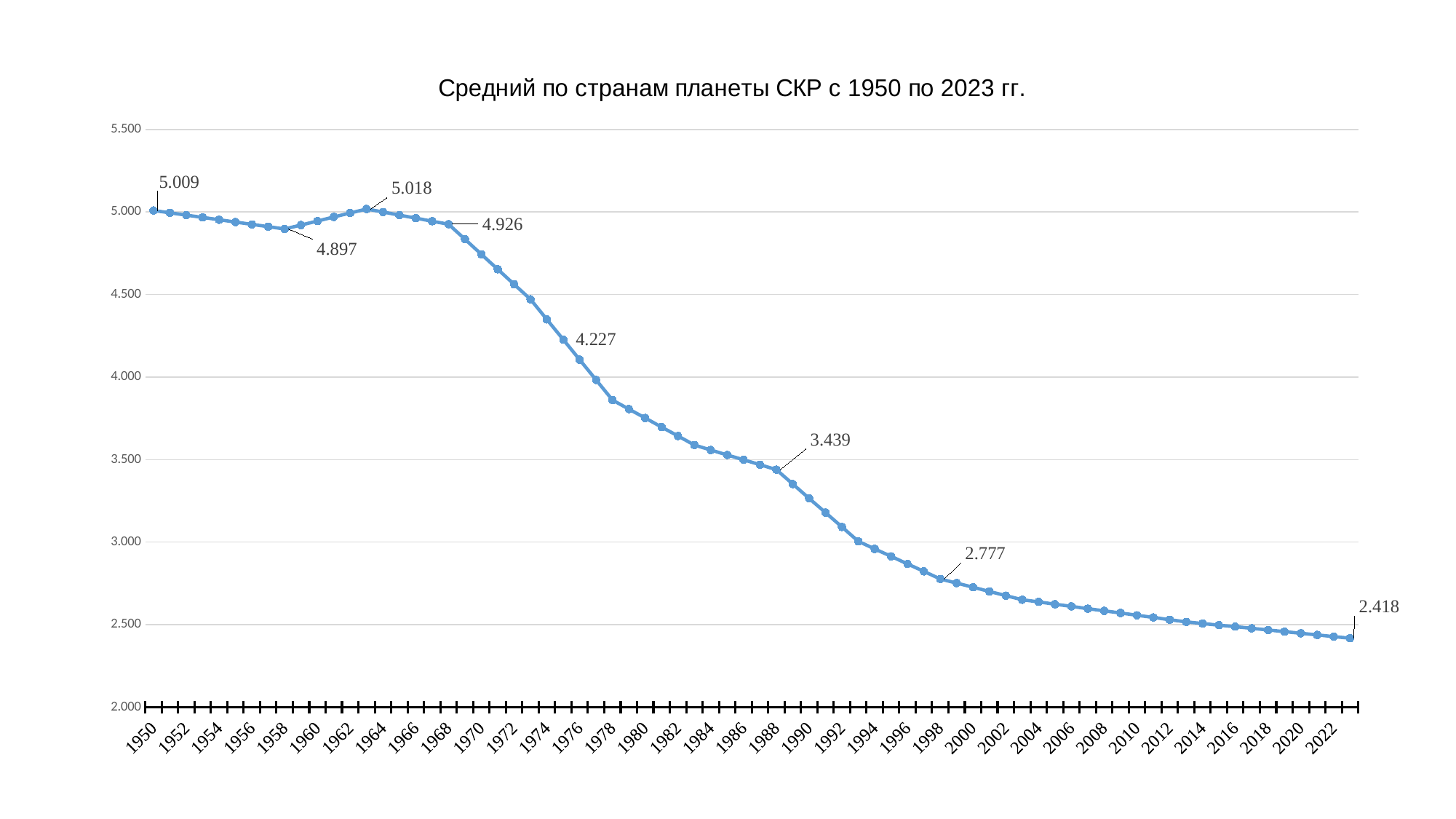
Is the value for 1980 greater or less than 4.000? less What is the value for 1998? 2.777 What is the value for 1950? 5.009 What is the title of the chart? Средний по странам планеты СКР с 1950 по 2023 гг. What kind of chart is shown on the slide? line chart What is the difference between the values for 1950 and 2023? 2.591 What is the value for 2023? 2.418 What is the value for 1958? 4.897 What is the value for 1988? 3.439 Do the values generally rise or fall from 1968 to 2023? fall In which year is the value lowest? 2023 What is the value for 1963? 5.018